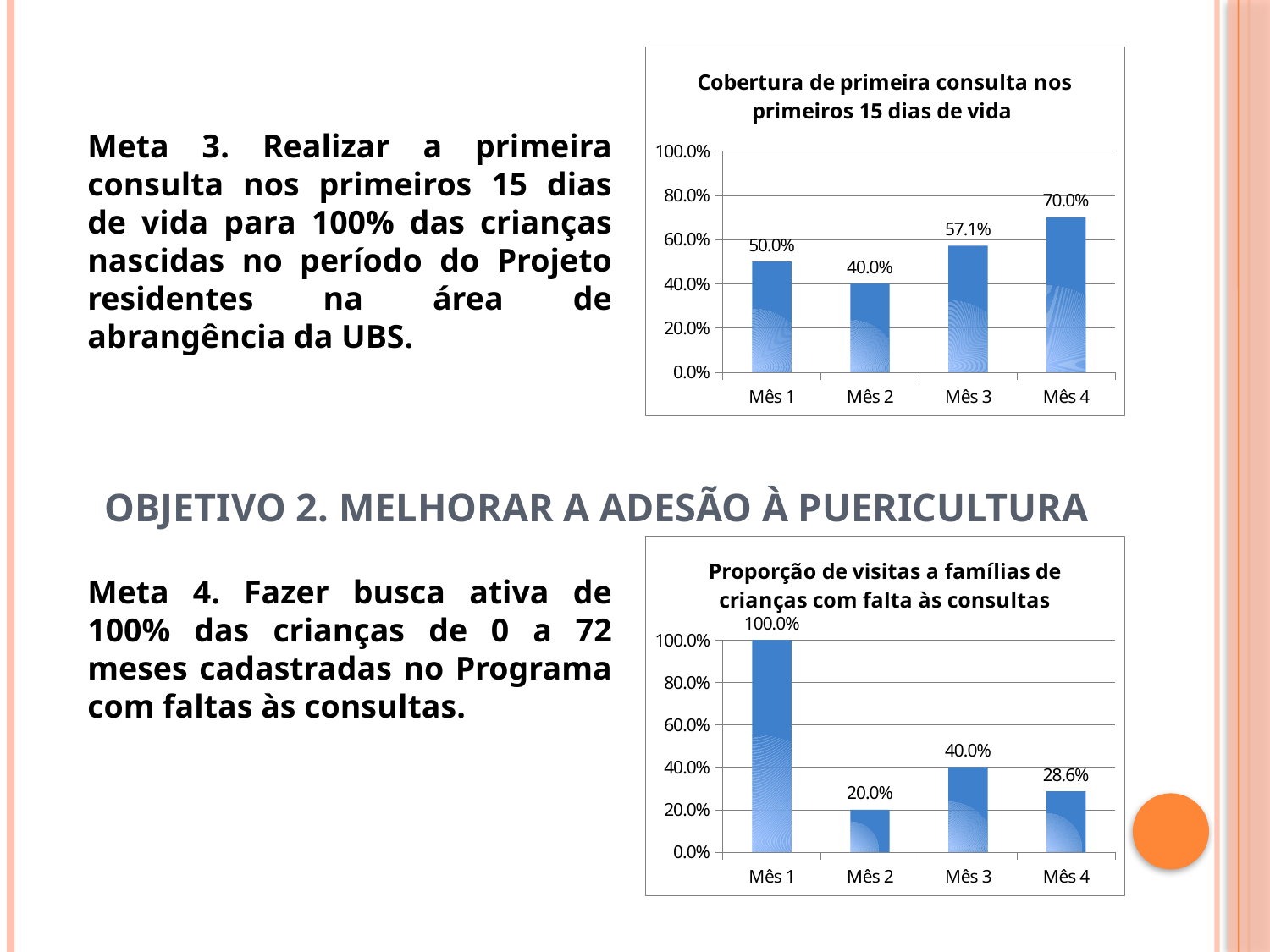
In the chart 'Proporção de visitas a famílias de crianças com falta às consultas', which is larger, the value for Mês 3 or Mês 4? Mês 3 In the chart 'Proporção de visitas a famílias de crianças com falta às consultas', what is the difference between the values for Mês 1 and Mês 2? 80.0% In the chart 'Cobertura de primeira consulta nos primeiros 15 dias de vida', which month has the highest value? Mês 4 In the chart 'Cobertura de primeira consulta nos primeiros 15 dias de vida', how many months are shown on the x axis? 4 In the chart 'Cobertura de primeira consulta nos primeiros 15 dias de vida', which month has the lowest value? Mês 2 What kind of chart is the top chart on the slide? Bar chart In the chart 'Proporção de visitas a famílias de crianças com falta às consultas', which month has the highest value? Mês 1 In the chart 'Proporção de visitas a famílias de crianças com falta às consultas', what is the value for Mês 4? 28.6% In the chart 'Proporção de visitas a famílias de crianças com falta às consultas', which month has the lowest value? Mês 2 In the chart 'Cobertura de primeira consulta nos primeiros 15 dias de vida', what is the difference between the values for Mês 4 and Mês 1? 20.0% In the chart 'Cobertura de primeira consulta nos primeiros 15 dias de vida', what is the value for Mês 3? 57.1% In the chart 'Cobertura de primeira consulta nos primeiros 15 dias de vida', is the value for Mês 2 greater or less than 60.0%? less